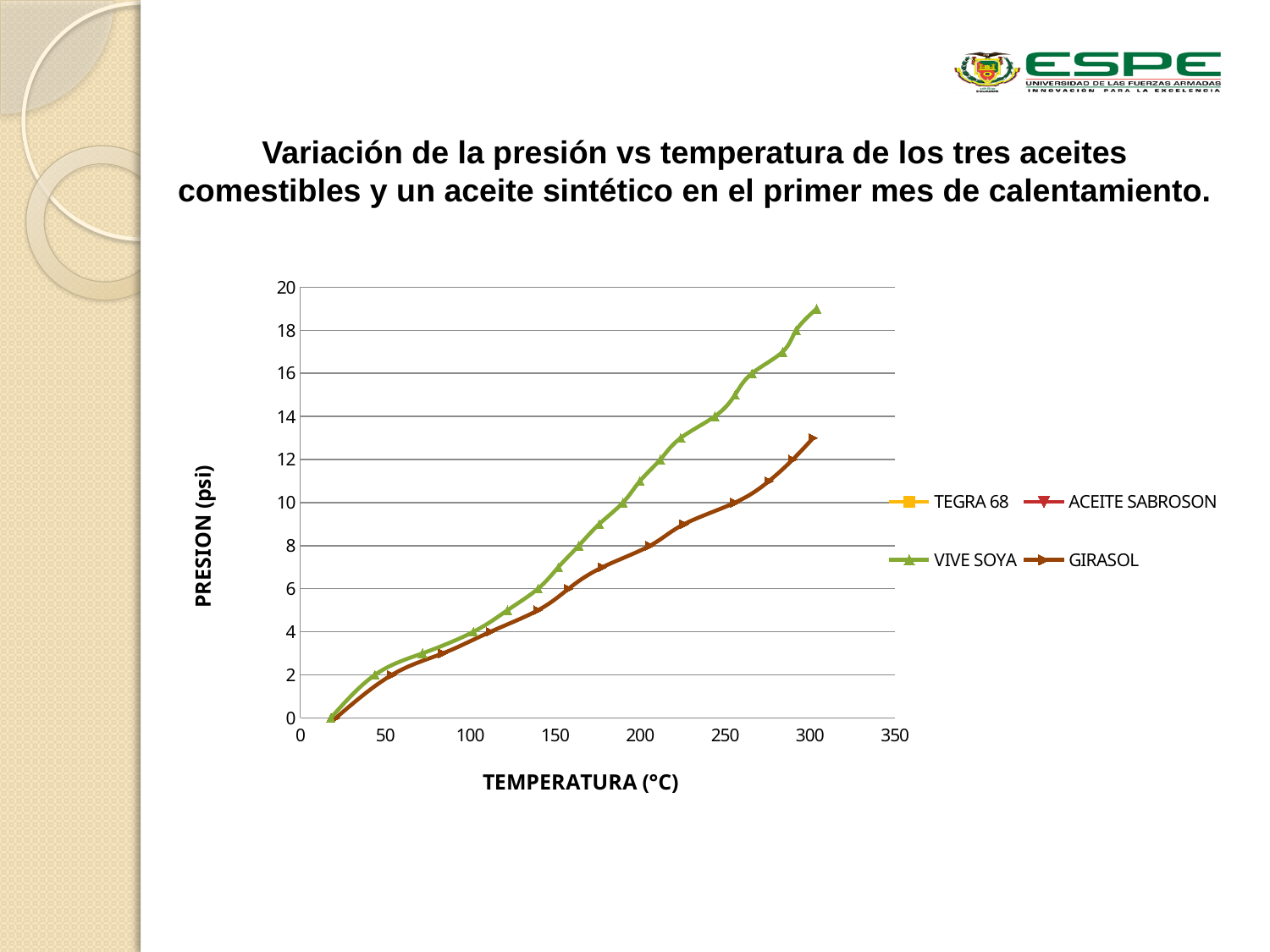
How many series does the legend list? 4 Is the highest pressure value for GIRASOL greater or less than 14 psi? less What is the label of the x axis? TEMPERATURA (°C) Is the pressure for VIVE SOYA at about 200 °C greater or less than 8 psi? greater At around 300 °C, which series has the higher pressure, VIVE SOYA or GIRASOL? VIVE SOYA What is the label of the y axis? PRESION (psi) Is the highest pressure value for VIVE SOYA greater or less than 18 psi? greater Which series reaches the highest pressure on the chart? VIVE SOYA What kind of chart is shown on the slide? line chart Do the pressure values rise or fall as temperature increases along the x axis? rise